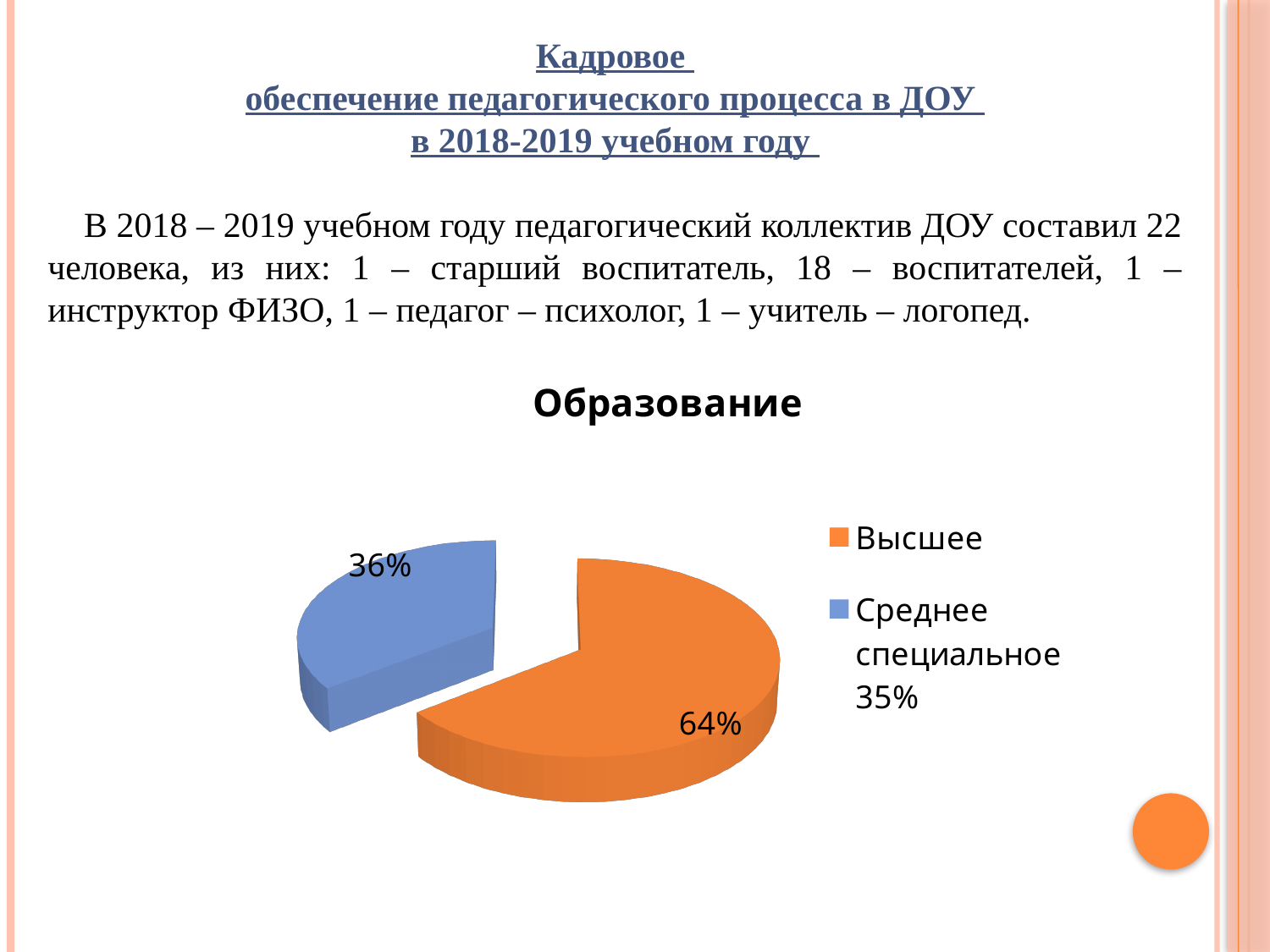
What kind of chart is shown on the slide? pie chart What colour is the Высшее slice? orange Which slice is larger, Высшее or Среднее специальное? Высшее What percentage of the pie is labelled for Высшее? 64% What is the title of the chart? Образование How many entries does the legend list? 2 Which category has the smallest slice of the pie? Среднее специальное How many slices does the pie chart have? 2 Is the value for Высшее greater or less than 50%? greater Which category has the largest slice of the pie? Высшее Is the value for Среднее специальное greater or less than 50%? less